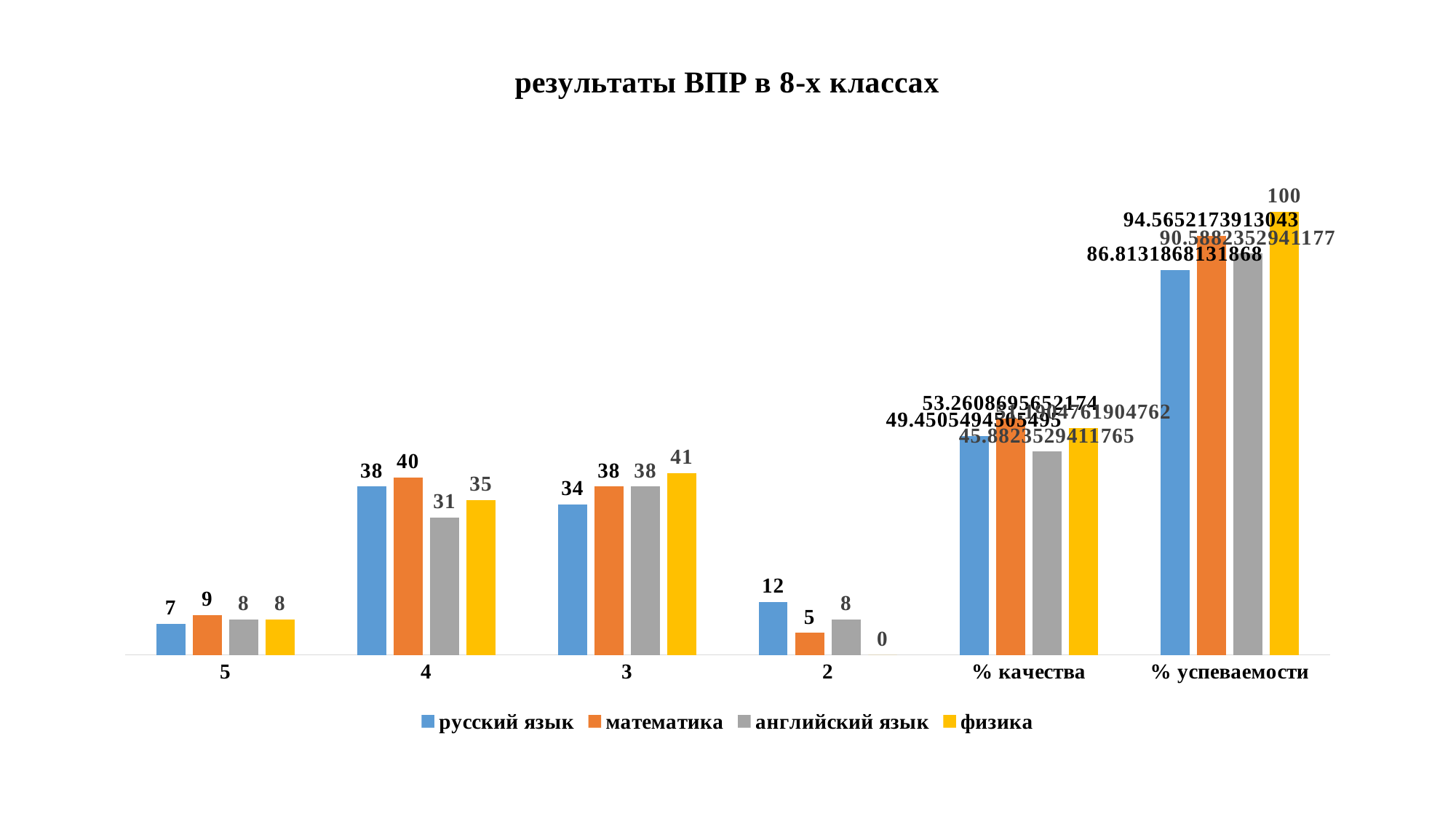
What type of chart is shown on the slide? bar chart What is the value for английский язык for % качества? 45.8823529411765 What is the value for русский язык for % успеваемости? 86.8131868131868 What is the value for физика in category 2? 0 Which is larger in category 2: русский язык or математика? русский язык What is the value for математика in category 4? 40 Which series has the lowest value in category 4? английский язык How many series does the legend list? 4 How many categories are shown on the x axis? 6 Which series has the highest value for % успеваемости? физика What is the title of the chart? результаты ВПР в 8-х классах What is the difference between физика and русский язык in category 3? 7